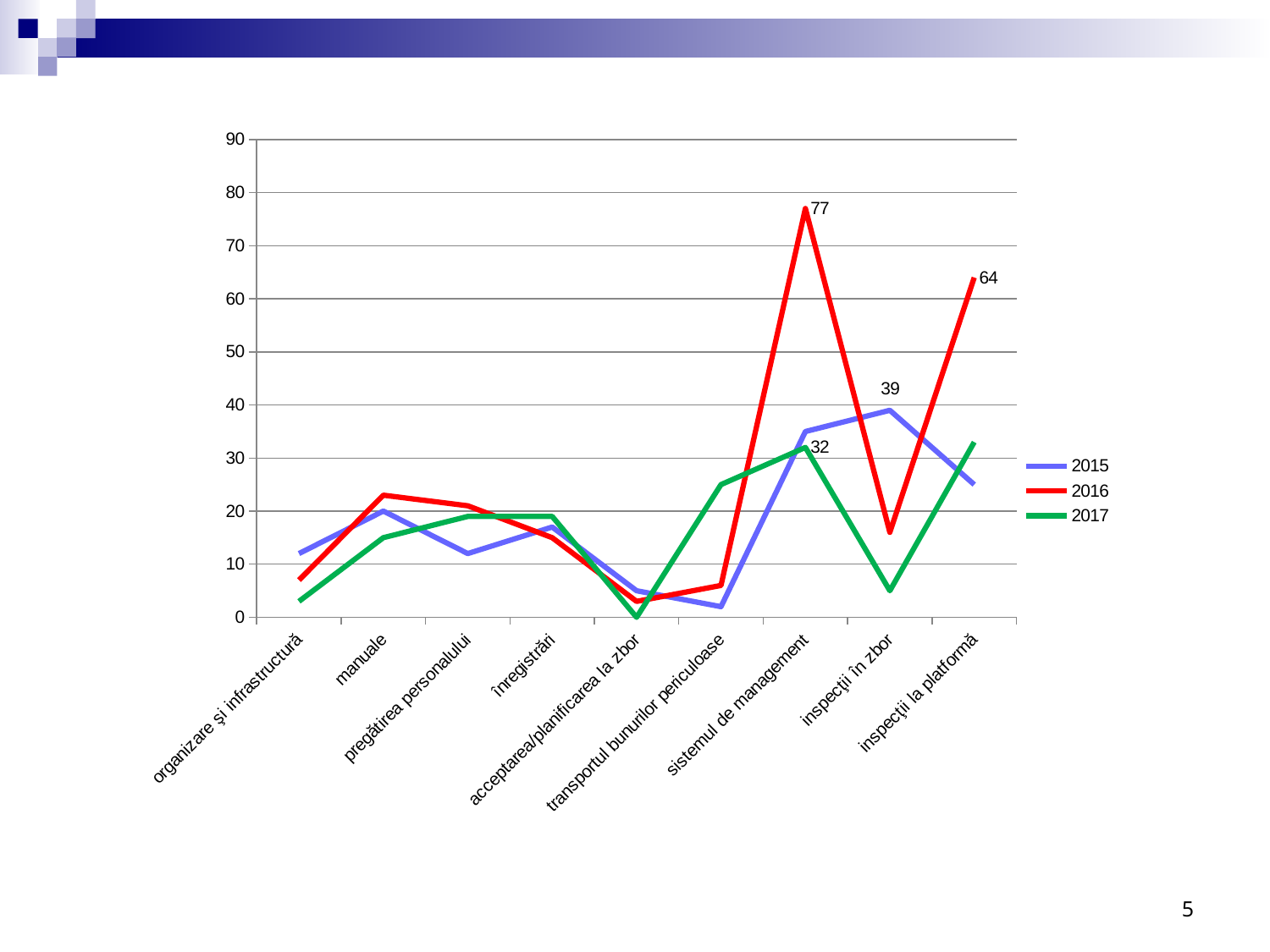
What kind of chart is shown on the slide? line chart How many series does the legend list? 3 What is the value for 2015 in the category 'inspecţii în zbor'? 39 How many categories are shown along the x axis? 9 What is the value for 2016 in the category 'inspecţii la platformă'? 64 In which category does the 2016 series reach its highest value? sistemul de management What is the value for 2016 in the category 'sistemul de management'? 77 Is the value for 2017 in the category 'inspecţii în zbor' greater or less than 10? less In which category does the 2017 series reach its lowest value? acceptarea/planificarea la zbor In the category 'sistemul de management', which series has the larger value, 2016 or 2017? 2016 What is the difference between the 2016 and 2017 values for 'sistemul de management'? 45 What is the value for 2017 in the category 'sistemul de management'? 32